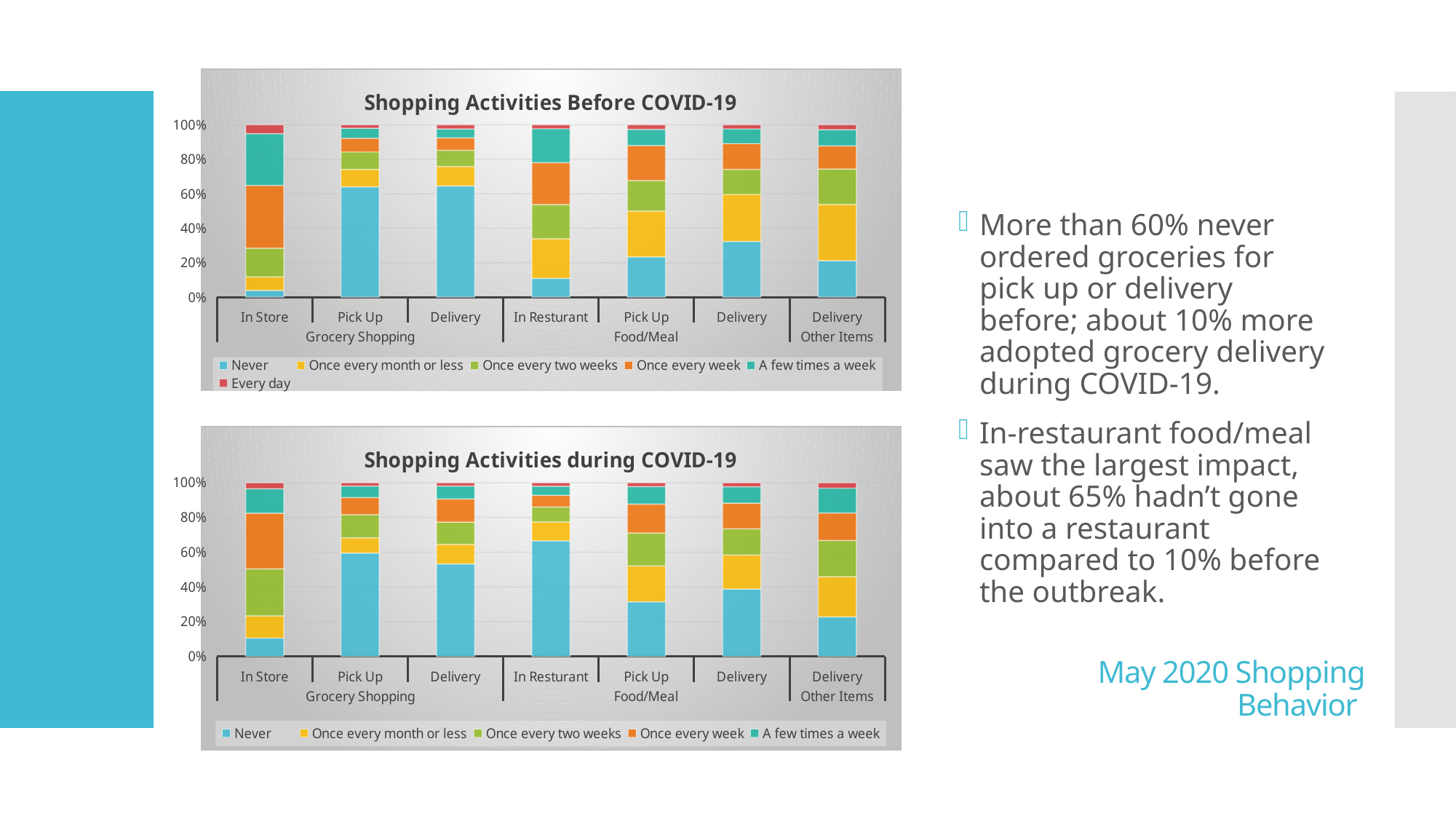
In the "Shopping Activities Before COVID-19" chart, which has the larger "Never" segment: In Store grocery shopping or Pick Up grocery shopping? Pick Up (Grocery Shopping) How many categories are shown on the x axis of the "Shopping Activities during COVID-19" chart? 7 In the "Shopping Activities during COVID-19" chart, which has the larger "Never" segment: In Store grocery shopping or In Resturant food/meal? In Resturant (Food/Meal) In the "Shopping Activities during COVID-19" chart, which category has the largest "Never" segment? In Resturant (Food/Meal) In the "Shopping Activities Before COVID-19" chart, which category has the smallest "Never" segment? In Store (Grocery Shopping) How many series does the legend of the "Shopping Activities during COVID-19" chart list? 5 What is the title of the lower chart on the slide? Shopping Activities during COVID-19 In the "Shopping Activities Before COVID-19" chart, is the "Never" share for Pick Up grocery shopping greater or less than 60%? greater What kind of chart is "Shopping Activities Before COVID-19"? Stacked bar chart How many series does the legend of the "Shopping Activities Before COVID-19" chart list? 6 In the "Shopping Activities during COVID-19" chart, is the "Never" share for In Resturant food/meal greater or less than 60%? greater In the "Shopping Activities Before COVID-19" chart, is the "Never" share for In Store grocery shopping greater or less than 20%? less